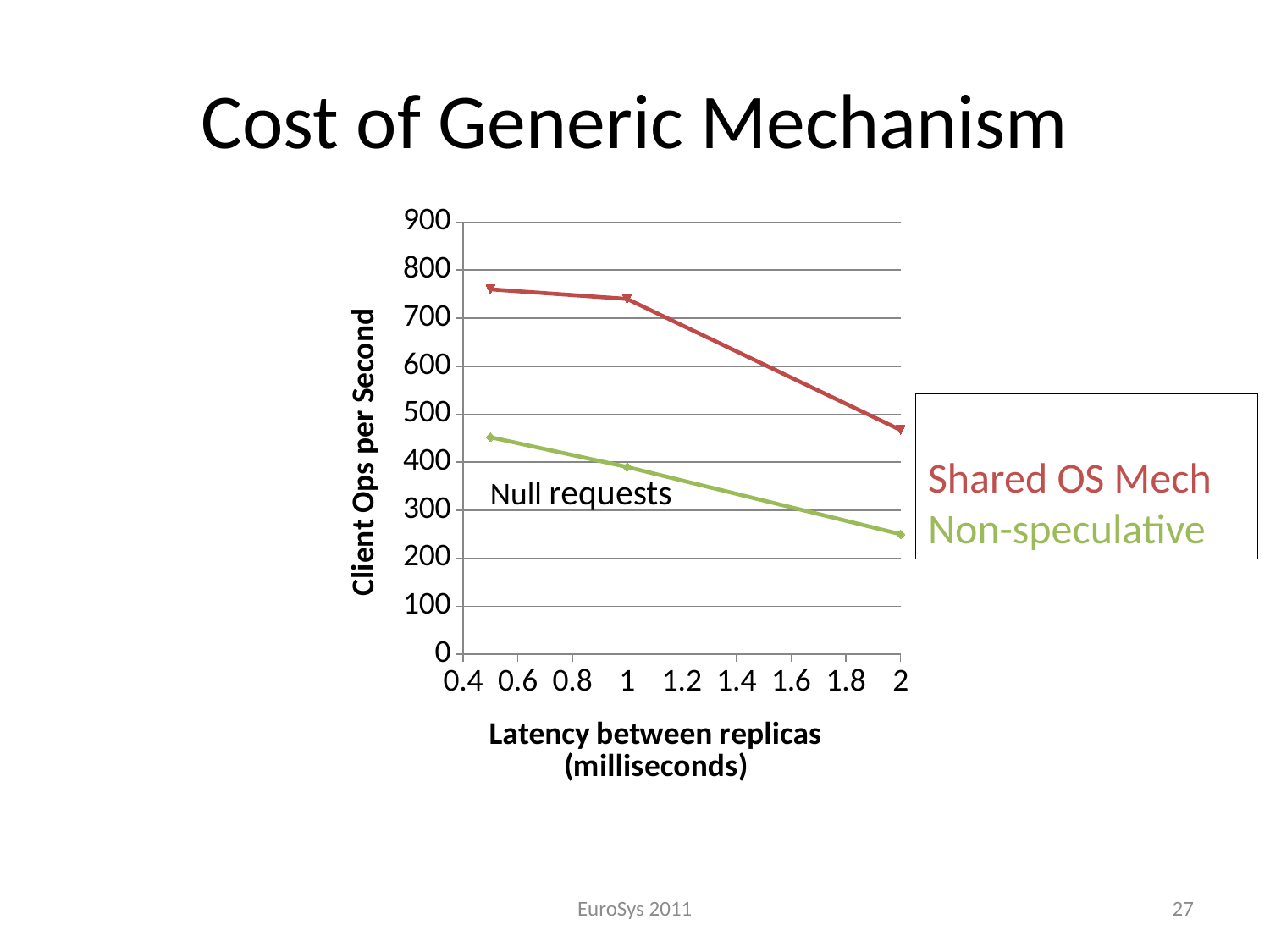
What kind of chart is shown on the slide? line chart Is the Shared OS Mech value at a latency of 2 milliseconds greater or less than 400? greater Do the Shared OS Mech values rise or fall as latency between replicas increases? fall What is the title of the vertical axis? Client Ops per Second Is the Non-speculative value at the lowest plotted latency greater or less than 400? greater Which series has the higher client ops per second at a latency of 1 millisecond, Shared OS Mech or Non-speculative? Shared OS Mech How many series does the legend list? 2 Is the Shared OS Mech value at the lowest plotted latency greater or less than 700? greater Do the Non-speculative values rise or fall as latency between replicas increases? fall How many data points are plotted for the Shared OS Mech series? 3 What is the title of the horizontal axis? Latency between replicas (milliseconds)